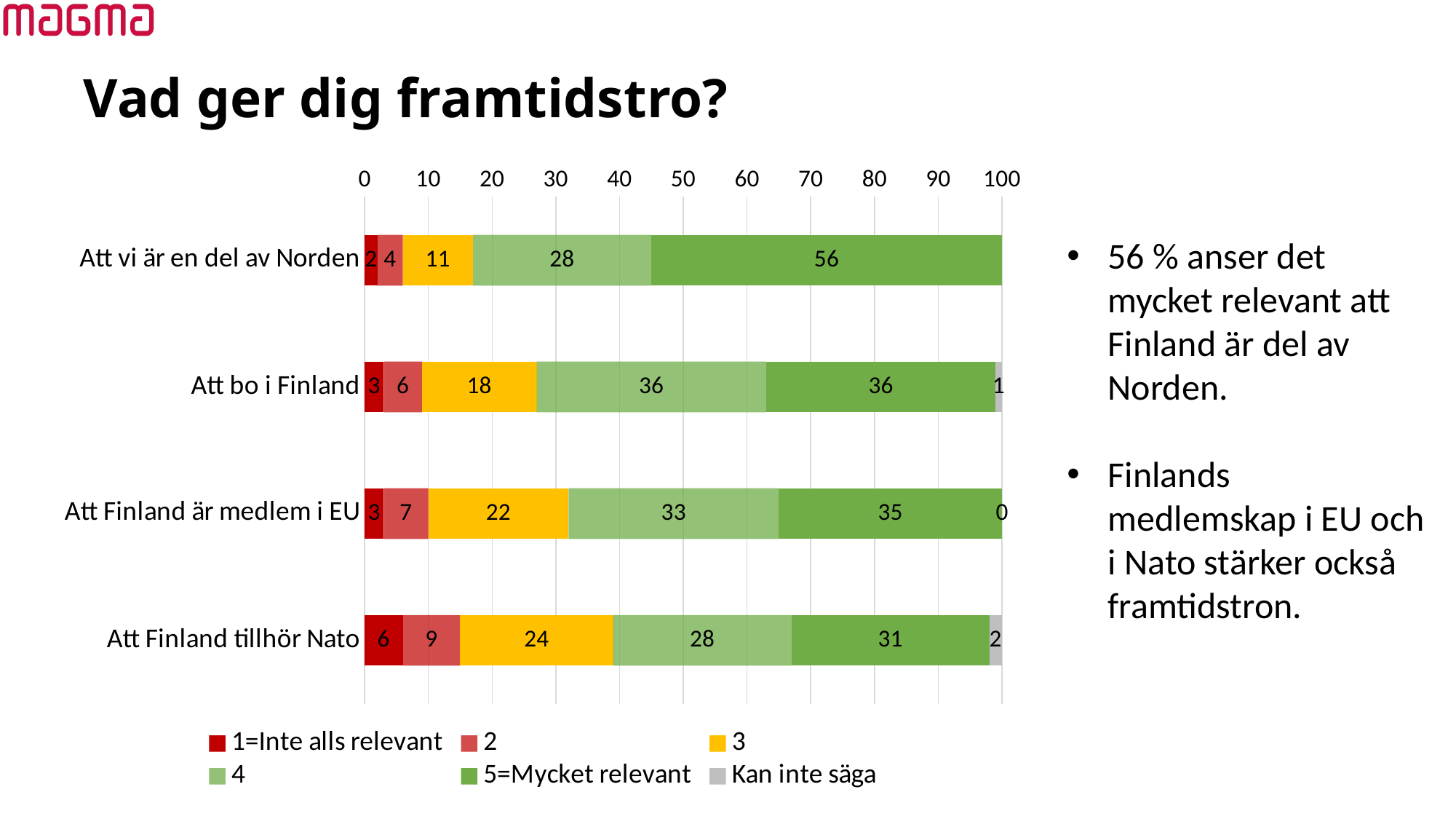
What is the difference between the '5=Mycket relevant' values for 'Att vi är en del av Norden' and 'Att Finland tillhör Nato'? 25 How many series does the legend list? 6 Which category has the lowest value for '1=Inte alls relevant'? Att vi är en del av Norden Which category has the highest value for '5=Mycket relevant'? Att vi är en del av Norden What type of chart is shown on the slide? Stacked bar chart What is the value of 'Kan inte säga' for 'Att Finland är medlem i EU'? 0 Which is larger: the '3' value for 'Att Finland är medlem i EU' or for 'Att bo i Finland'? Att Finland är medlem i EU What is the value of '5=Mycket relevant' for 'Att vi är en del av Norden'? 56 How many categories are plotted on the chart? 4 What is the value of '3' for 'Att Finland tillhör Nato'? 24 What is the value of '4' for 'Att bo i Finland'? 36 What is the total of the stacked bar for 'Att Finland tillhör Nato'? 100